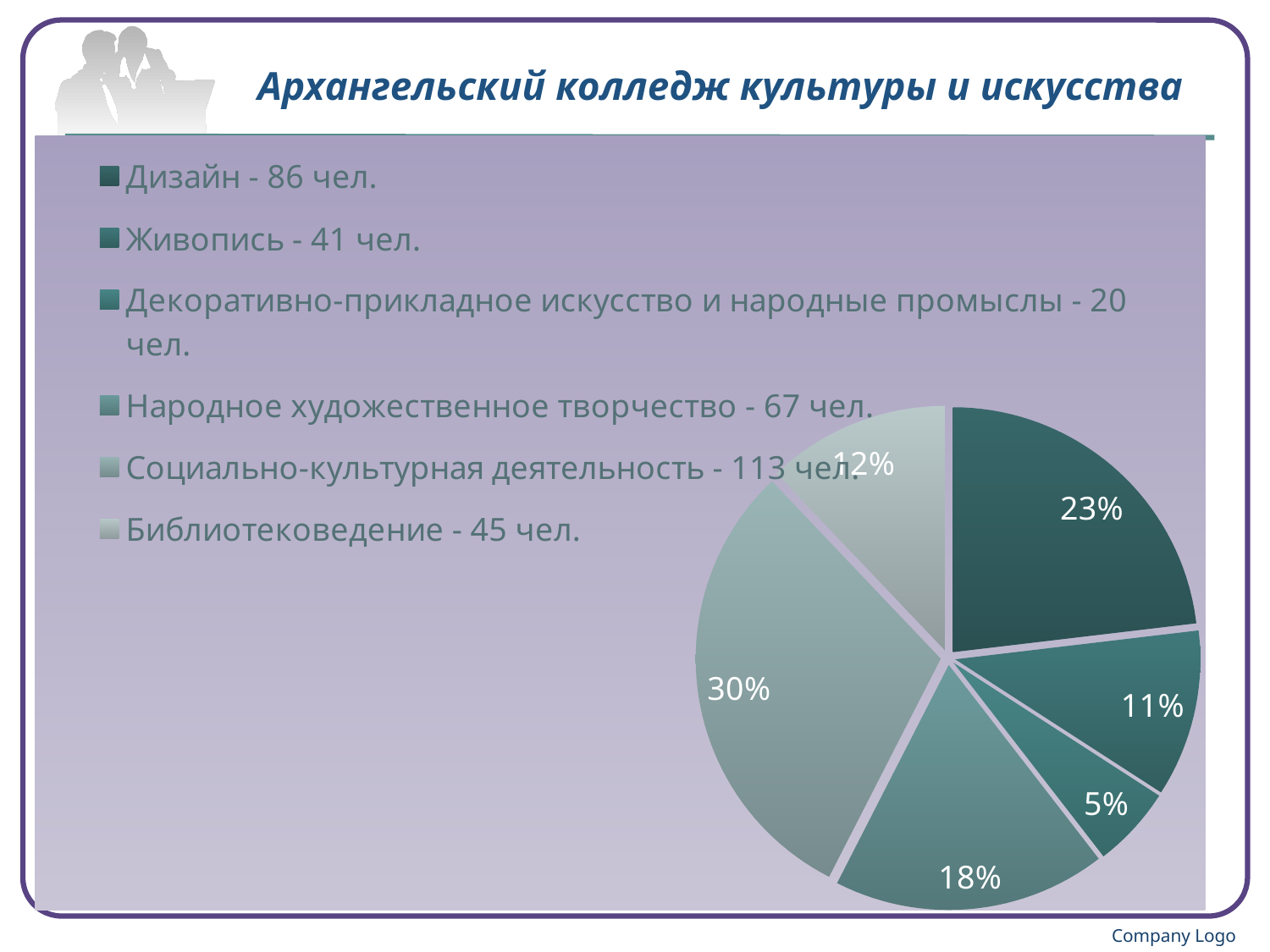
How many people are listed for Народное художественное творчество in the legend? 67 чел. Which slice is larger, Народное художественное творчество or Библиотековедение? Народное художественное творчество What share of the pie does Дизайн take? 23% Which category has the largest slice of the pie? Социально-культурная деятельность What share of the pie does Декоративно-прикладное искусство и народные промыслы take? 5% What is the difference in percentage points between the Социально-культурная деятельность slice and the Дизайн slice? 7% What kind of chart is shown on the slide? pie chart What share of the pie does Библиотековедение take? 12% How many people are listed for Живопись in the legend? 41 чел. Which category has the smallest slice of the pie? Декоративно-прикладное искусство и народные промыслы How many slices does the pie chart have? 6